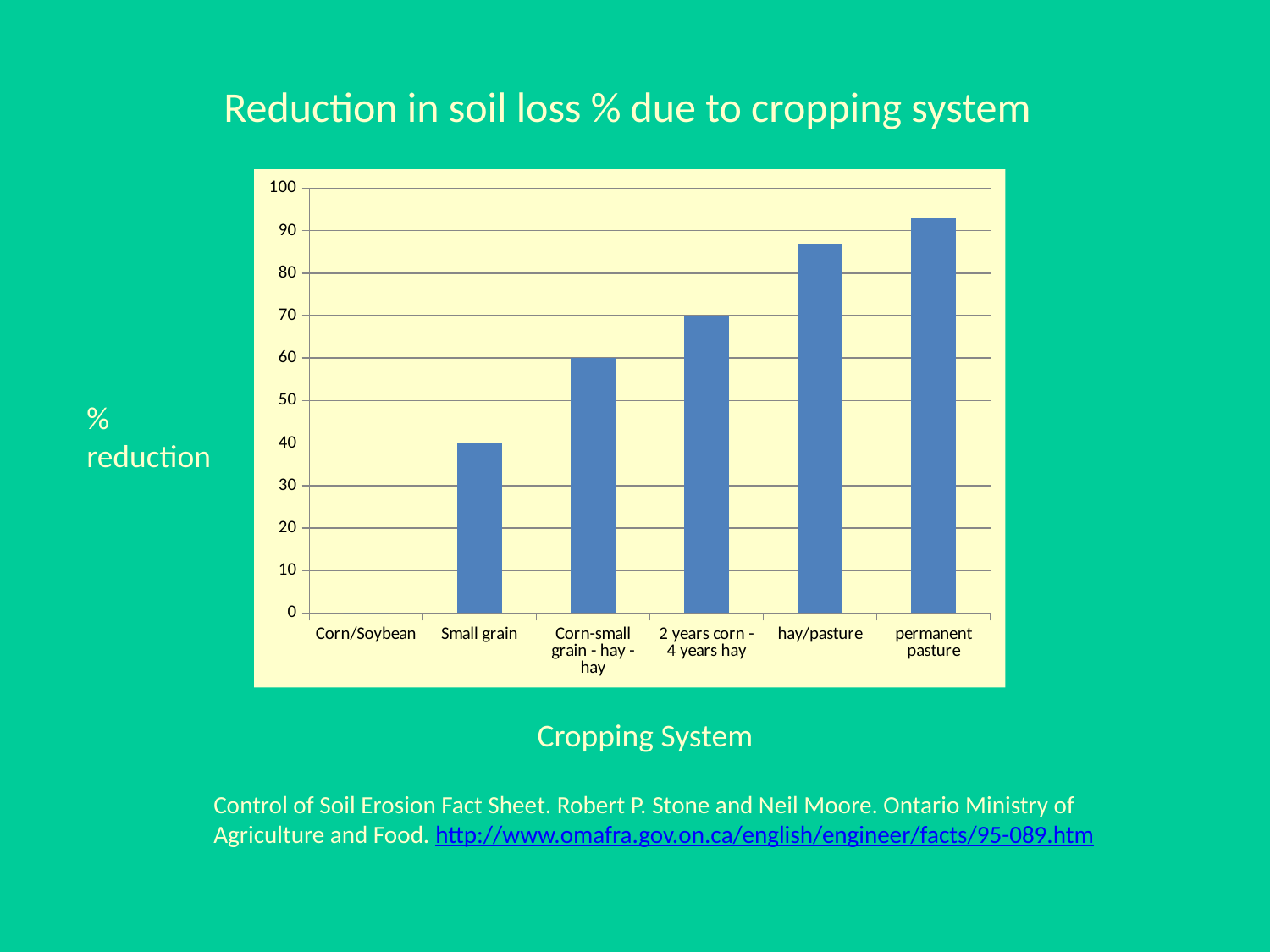
Do the values rise or fall moving from left to right along the x axis? Rise Which has a larger % reduction, hay/pasture or Corn-small grain - hay - hay? hay/pasture What is the difference in % reduction between 2 years corn - 4 years hay and Small grain? 30 Which cropping system has the lowest % reduction in soil loss? Corn/Soybean What is the % reduction value for Corn-small grain - hay - hay? 60 What is the % reduction value for 2 years corn - 4 years hay? 70 What type of chart is shown on the slide? Bar chart How many cropping systems are shown on the x axis? 6 Is the value for hay/pasture greater or less than 80? greater What is the % reduction value for Small grain? 40 What is the title of the chart? Reduction in soil loss % due to cropping system Which cropping system has the highest % reduction in soil loss? permanent pasture